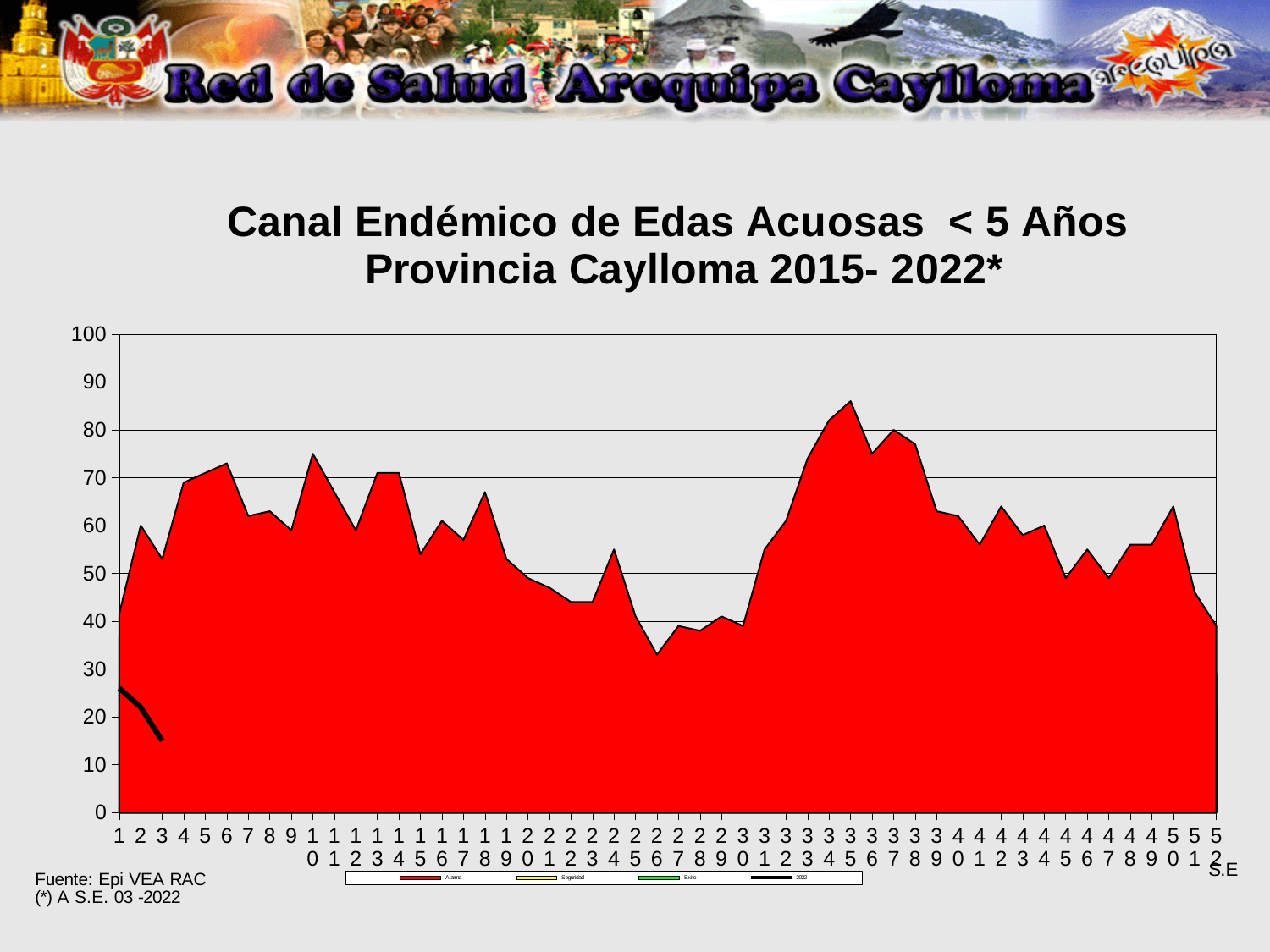
How many entries does the chart legend list? 4 At which week does the red area reach its highest point? 35 Is the value of the black 2022 line at week 3 greater or less than 20? less Is the value of the red area at week 35 greater or less than 80? greater Is the value of the red area at week 26 greater or less than 40? less What is the title of the chart? Canal Endémico de Edas Acuosas < 5 Años Provincia Caylloma 2015- 2022* What is the maximum value shown on the y axis? 100 How many epidemiological weeks (S.E.) are shown along the x axis? 52 At which week does the red area reach its lowest point? 26 Does the red area rise or fall between week 26 and week 35? rise What kind of chart is shown on the slide? area chart